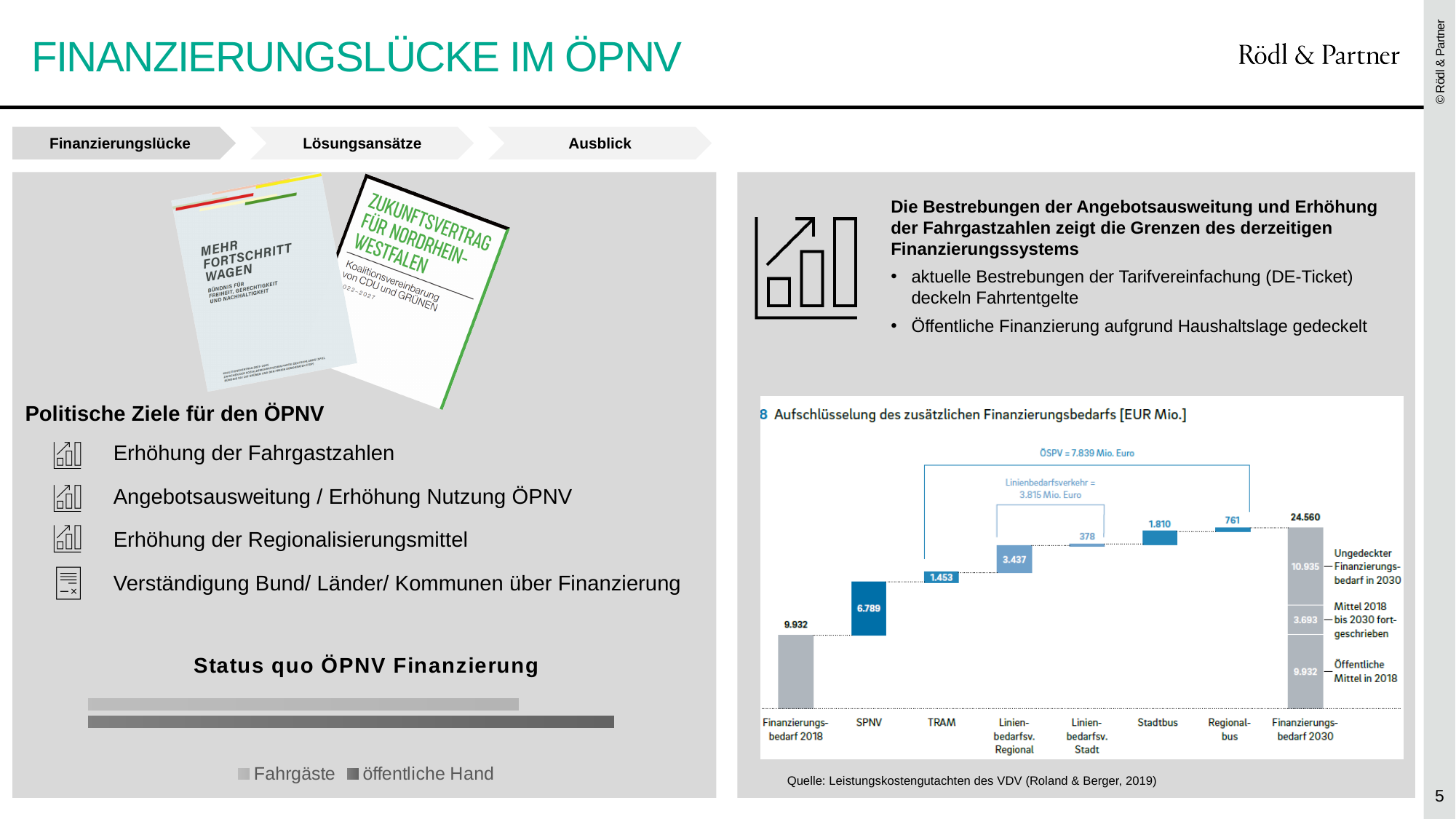
In the chart titled 'Aufschlüsselung des zusätzlichen Finanzierungsbedarfs [EUR Mio.]', what is the value for SPNV? 6.789 How many categories are shown on the x axis of the chart titled 'Aufschlüsselung des zusätzlichen Finanzierungsbedarfs [EUR Mio.]'? 8 How many series does the legend of the chart titled 'Status quo ÖPNV Finanzierung' list? 2 In the chart titled 'Aufschlüsselung des zusätzlichen Finanzierungsbedarfs [EUR Mio.]', what total is given for Linienbedarfsverkehr? 3.815 Mio. Euro In the chart titled 'Aufschlüsselung des zusätzlichen Finanzierungsbedarfs [EUR Mio.]', what is the value labelled 'Ungedeckter Finanzierungsbedarf in 2030' within the Finanzierungsbedarf 2030 bar? 10.935 In the chart titled 'Aufschlüsselung des zusätzlichen Finanzierungsbedarfs [EUR Mio.]', what total is given for ÖSPV? 7.839 Mio. Euro In the chart titled 'Aufschlüsselung des zusätzlichen Finanzierungsbedarfs [EUR Mio.]', what is the value for Finanzierungsbedarf 2030? 24.560 In the chart titled 'Status quo ÖPNV Finanzierung', which bar is longer: Fahrgäste or öffentliche Hand? öffentliche Hand In the chart titled 'Aufschlüsselung des zusätzlichen Finanzierungsbedarfs [EUR Mio.]', what is the value for Stadtbus? 1.810 In the chart titled 'Aufschlüsselung des zusätzlichen Finanzierungsbedarfs [EUR Mio.]', which of the increment categories between 2018 and 2030 has the smallest value? Linienbedarfsv. Stadt In the chart titled 'Aufschlüsselung des zusätzlichen Finanzierungsbedarfs [EUR Mio.]', what is the value for Linienbedarfsv. Stadt? 378 In the chart titled 'Aufschlüsselung des zusätzlichen Finanzierungsbedarfs [EUR Mio.]', which is larger: TRAM or Regionalbus? TRAM